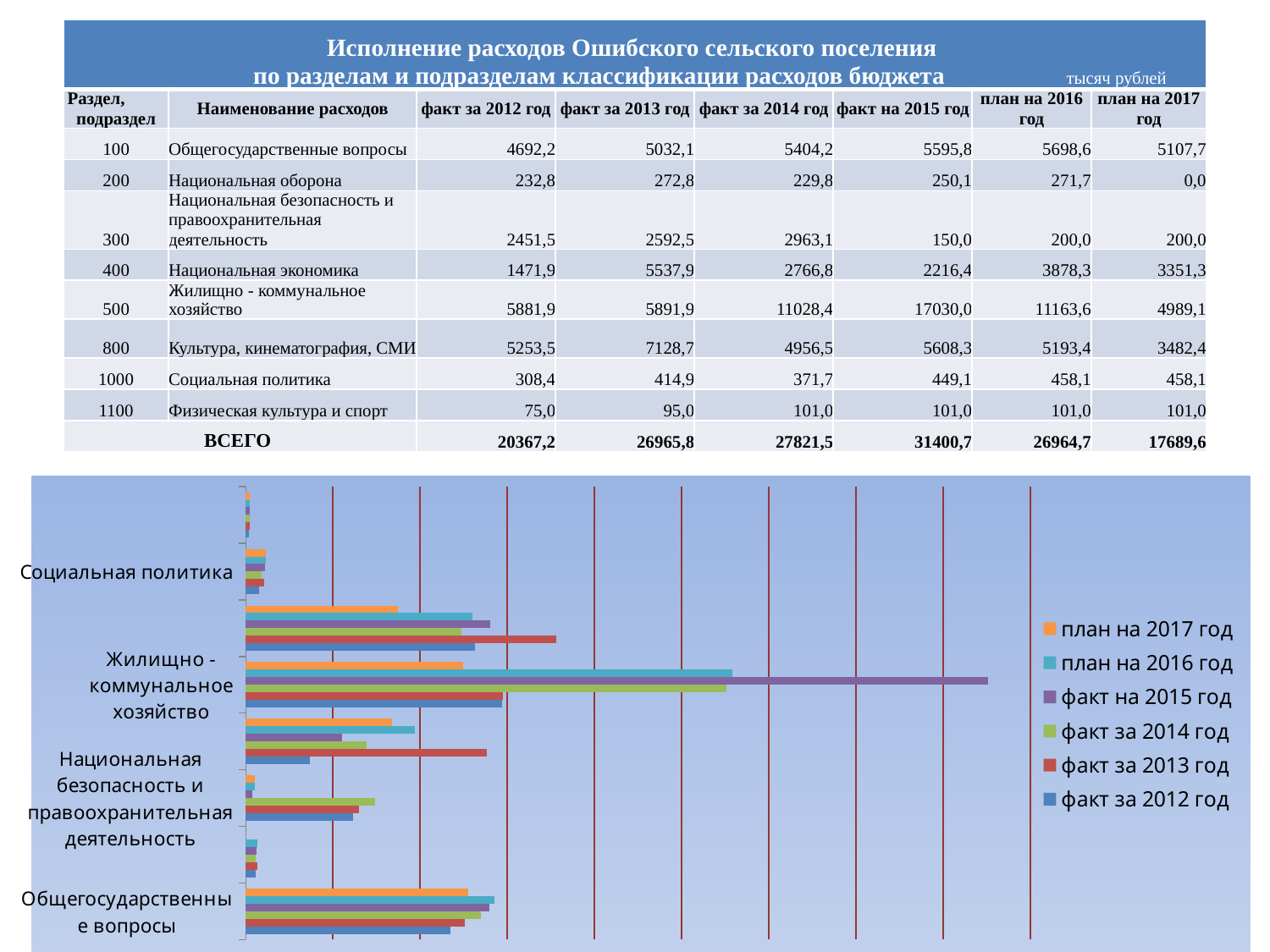
For Жилищно - коммунальное хозяйство, which series has the longest bar? факт на 2015 год Which series is shown in orange in the chart? план на 2017 год According to the slide, what is the value of факт на 2015 год for Жилищно - коммунальное хозяйство? 17030,0 According to the slide, what is the difference between план на 2016 год and план на 2017 год for Общегосударственные вопросы? 590,9 Which category has the longest bar in the chart? Жилищно - коммунальное хозяйство For Общегосударственные вопросы, which bar is longer: план на 2016 год or план на 2017 год? план на 2016 год How many series does the chart's legend list? 6 According to the slide, what is the value of план на 2017 год for Социальная политика? 458,1 Which series is listed first in the chart's legend? план на 2017 год How many groups of bars (categories) are plotted in the chart? 8 What kind of chart is shown on the slide? bar chart For Национальная безопасность и правоохранительная деятельность, which bar is longer: факт за 2014 год or план на 2017 год? факт за 2014 год